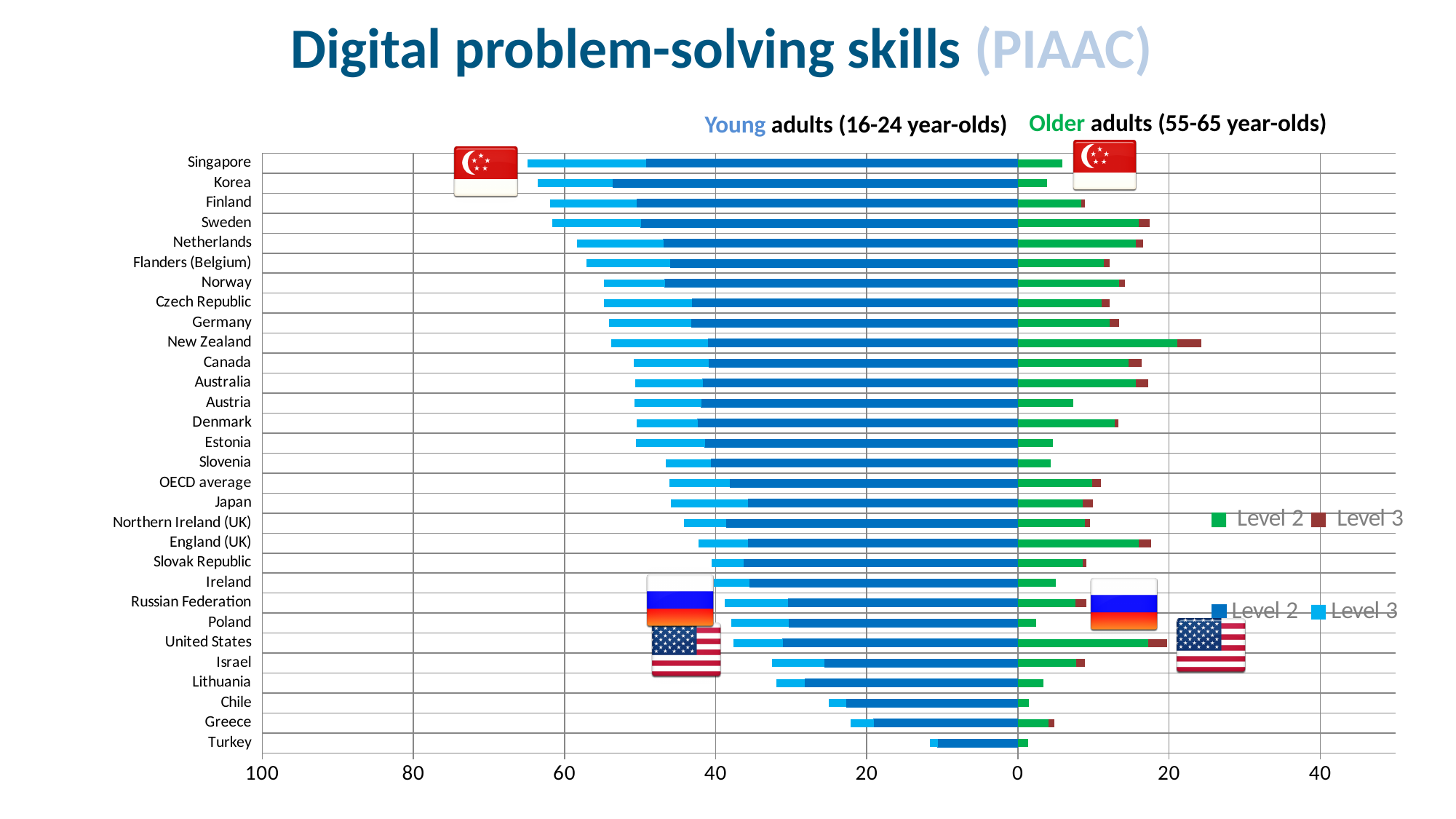
How many countries or regions are listed on the chart? 30 For older adults, which is larger: the bar for New Zealand or the bar for Singapore? New Zealand Which country has the longest bar for young adults (16-24 year-olds)? Singapore Is the total value for older adults in New Zealand greater or less than 20? greater Which country has the longest bar for older adults (55-65 year-olds)? New Zealand How many series do the legends list in total? 4 Is the total value for young adults in Turkey greater or less than 20? less What kind of chart is shown on the slide? bar chart Is the total value for young adults in the United States greater or less than 40? less Which two age groups does the chart compare? Young adults (16-24 year-olds) and Older adults (55-65 year-olds) Which country has the shortest bar for young adults (16-24 year-olds)? Turkey